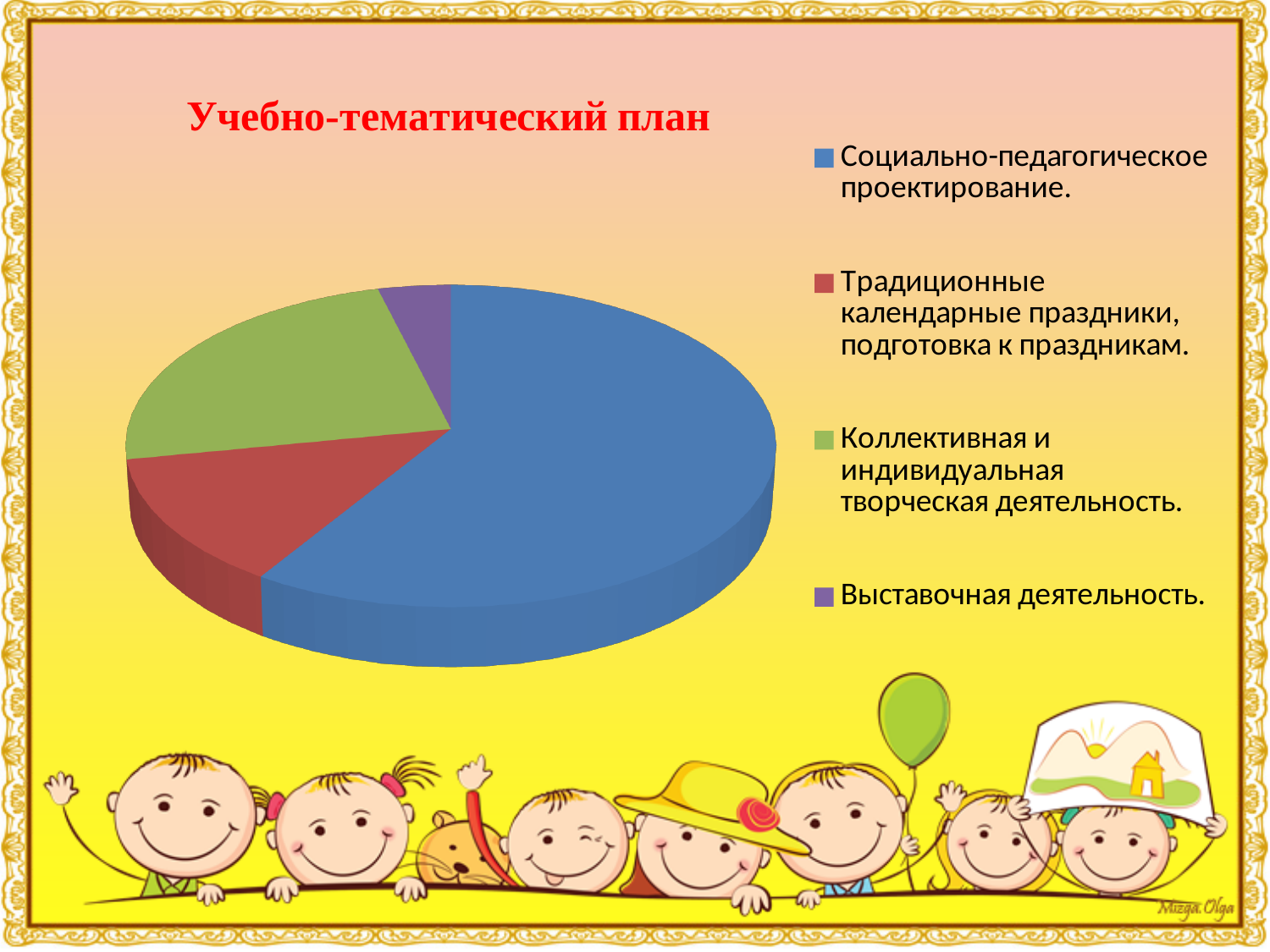
How many slices does the pie chart have? 4 What is the title of the slide containing the pie chart? Учебно-тематический план Which category has the smallest slice of the pie chart? Выставочная деятельность. How many entries does the legend of the pie chart list? 4 What kind of chart is shown on the slide? pie chart Which category has the largest slice of the pie chart? Социально-педагогическое проектирование. What colour is the slice for Коллективная и индивидуальная творческая деятельность in the pie chart? green Which slice is larger: Выставочная деятельность or Социально-педагогическое проектирование? Социально-педагогическое проектирование. Which slice is larger: Традиционные календарные праздники, подготовка к праздникам or Выставочная деятельность? Традиционные календарные праздники, подготовка к праздникам. Which slice is larger: Социально-педагогическое проектирование or Коллективная и индивидуальная творческая деятельность? Социально-педагогическое проектирование.